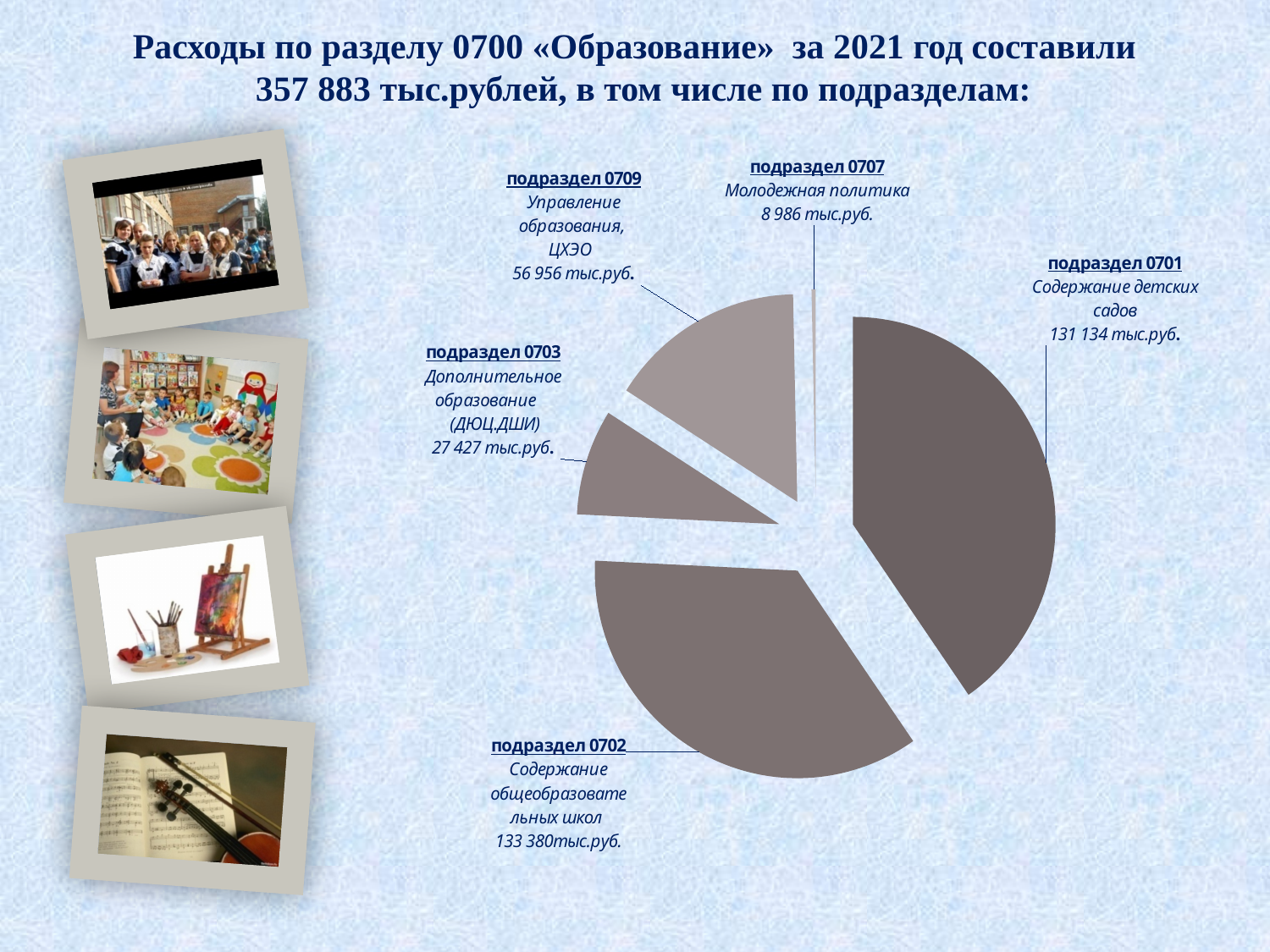
What is the value for подраздел 0707 (Молодежная политика)? 8 986 тыс.руб. What is the value for подраздел 0701 (Содержание детских садов)? 131 134 тыс.руб. What kind of chart is shown on the slide? pie chart Which subsection has the smallest expenditure? подраздел 0707 (Молодежная политика) Which is larger: the value for подраздел 0709 or подраздел 0703? подраздел 0709 What is the value for подраздел 0709 (Управление образования, ЦХЭО)? 56 956 тыс.руб. What is the value for подраздел 0703 (Дополнительное образование)? 27 427 тыс.руб. What is the value for подраздел 0702 (Содержание общеобразовательных школ)? 133 380 тыс.руб. Which subsection has the largest expenditure? подраздел 0702 (Содержание общеобразовательных школ) What is the difference between the values for подраздел 0709 and подраздел 0703? 29 529 тыс.руб. What is the total expenditure under section 0700 «Образование» for 2021 according to the slide? 357 883 тыс.рублей How many slices (subsections) does the pie chart have? 5